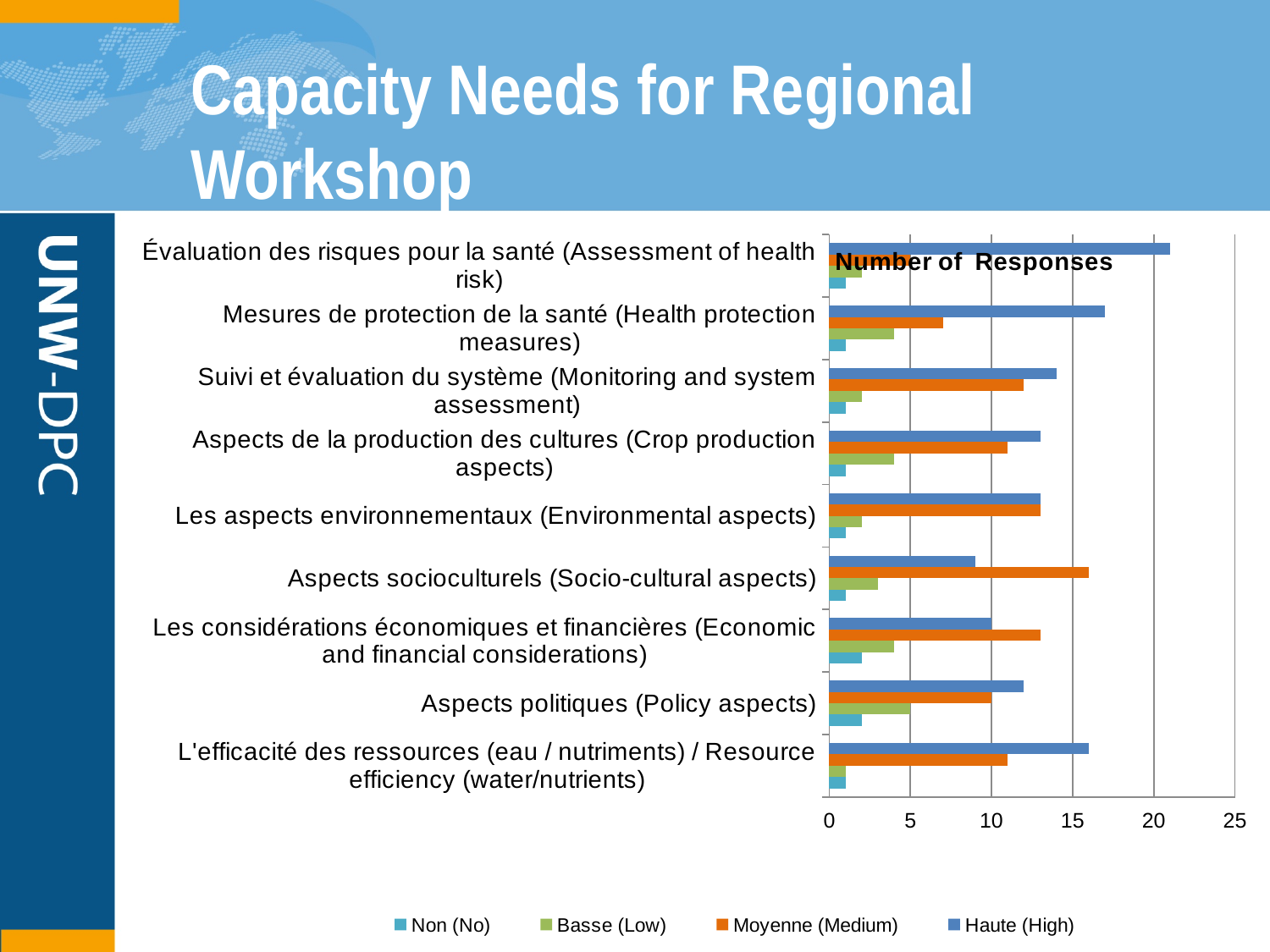
Is the Haute (High) value for Évaluation des risques pour la santé (Assessment of health risk) greater or less than 20? greater Is the Moyenne (Medium) value for Aspects socioculturels (Socio-cultural aspects) greater or less than 10? greater How many categories are plotted on the chart? 9 Is the Basse (Low) value for Aspects politiques (Policy aspects) greater or less than 10? less For Mesures de protection de la santé (Health protection measures), which is larger: the Haute (High) value or the Moyenne (Medium) value? Haute (High) Which category has the highest value for the Haute (High) series? Évaluation des risques pour la santé (Assessment of health risk) How many series does the legend list? 4 For Aspects socioculturels (Socio-cultural aspects), which is larger: the Moyenne (Medium) value or the Haute (High) value? Moyenne (Medium) Which category has the highest value for the Moyenne (Medium) series? Aspects socioculturels (Socio-cultural aspects) What is the title shown on the chart? Number of Responses What kind of chart is shown on the slide? bar chart